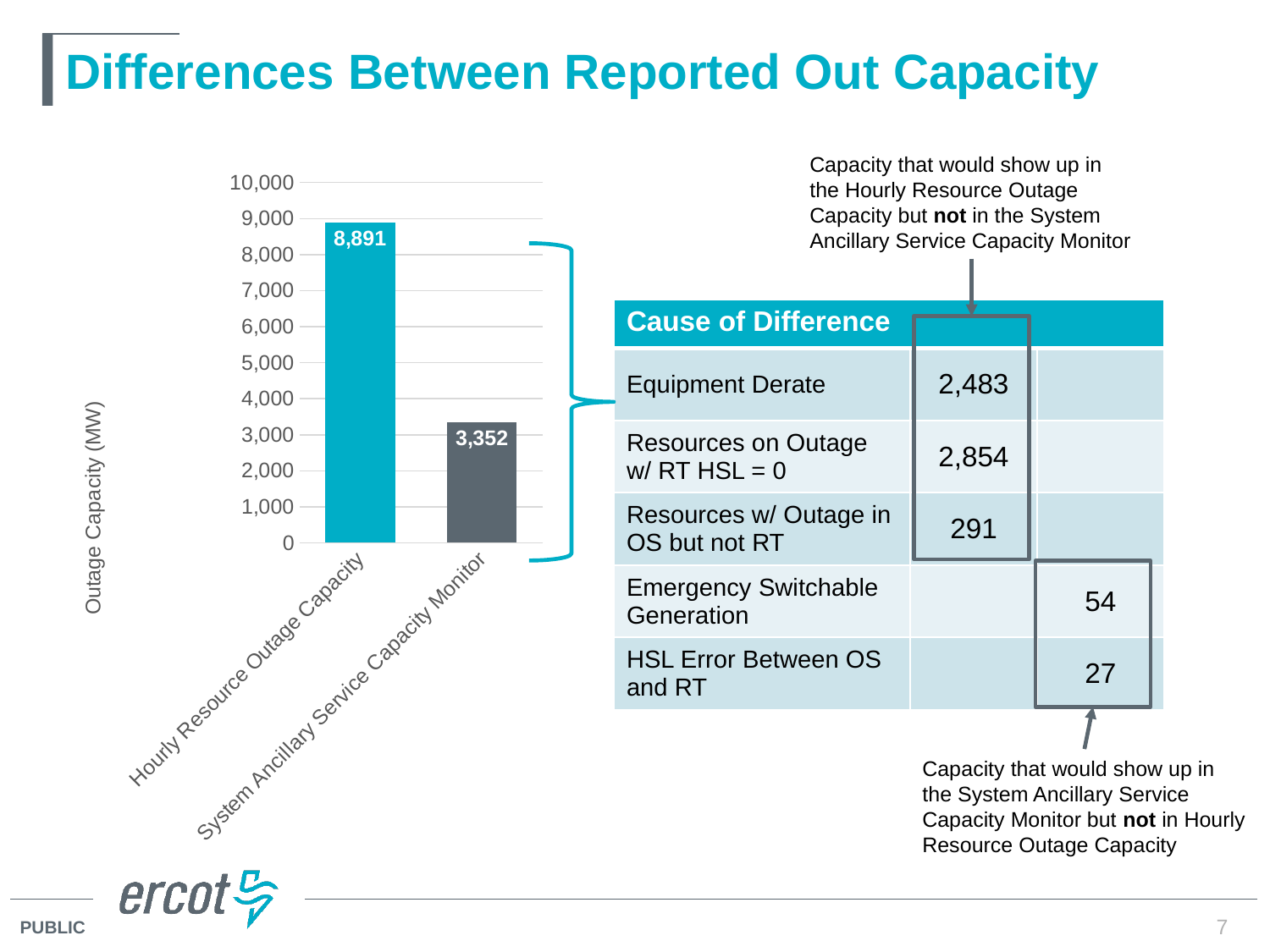
What kind of chart is shown on the slide? bar chart How many bars are shown in the chart? 2 What is the label of the vertical axis of the chart? Outage Capacity (MW) Which category has the lowest outage capacity? System Ancillary Service Capacity Monitor Is the value for Hourly Resource Outage Capacity greater or less than 8,000? greater What is the maximum value shown on the vertical axis of the chart? 10,000 What is the value for System Ancillary Service Capacity Monitor? 3,352 What is the difference between the Hourly Resource Outage Capacity and the System Ancillary Service Capacity Monitor values? 5,539 Which is larger, the value for Hourly Resource Outage Capacity or for System Ancillary Service Capacity Monitor? Hourly Resource Outage Capacity Which category has the highest outage capacity? Hourly Resource Outage Capacity Is the value for System Ancillary Service Capacity Monitor greater or less than 4,000? less What is the value for Hourly Resource Outage Capacity? 8,891